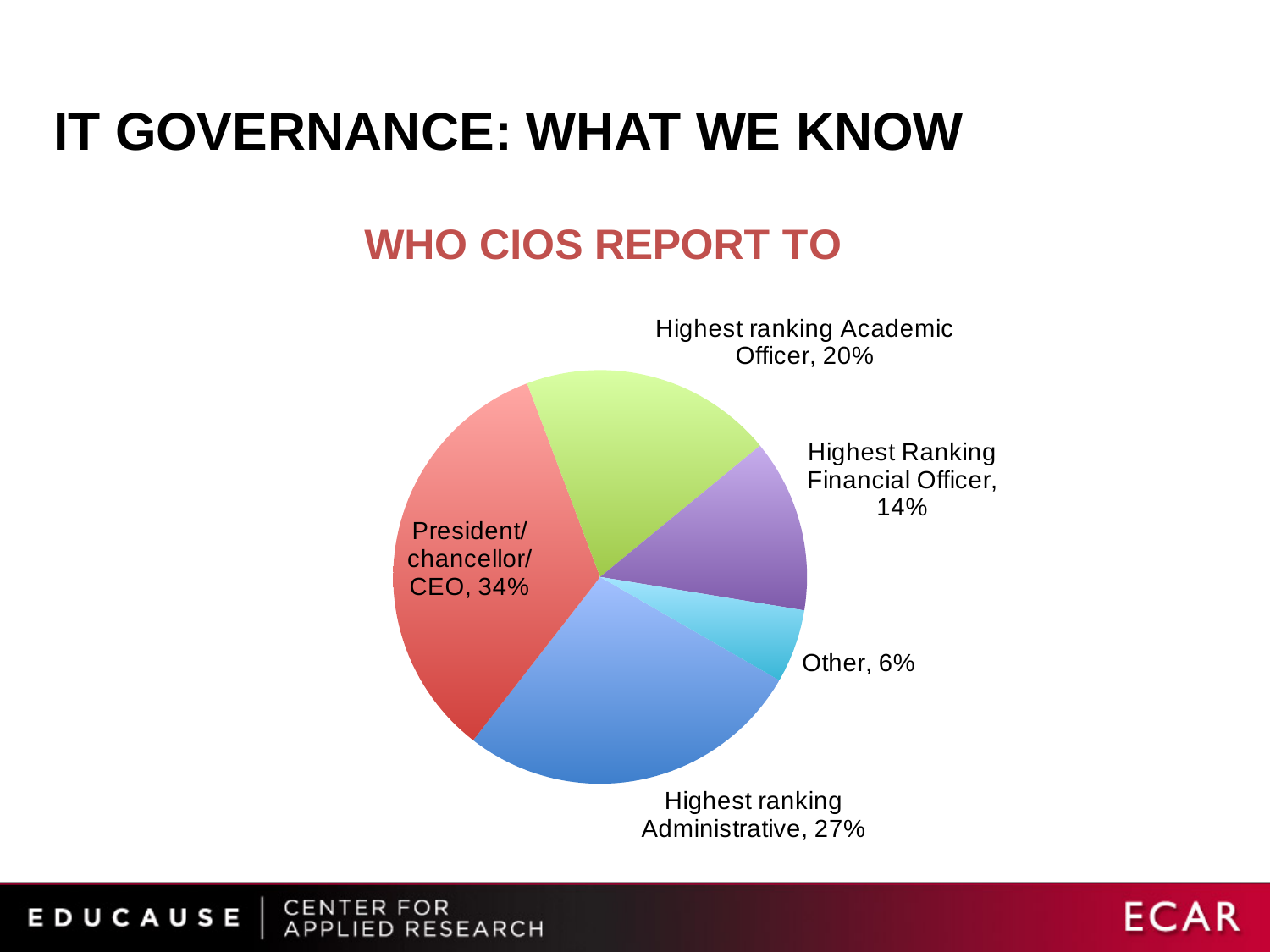
What is the value for the Other slice? 6% What percentage of CIOs report to the Highest Ranking Financial Officer? 14% What percentage of CIOs report to the Highest ranking Academic Officer? 20% Which category has the largest share of the pie? President/chancellor/CEO What kind of chart is shown on the slide? pie chart What percentage of CIOs report to the President/chancellor/CEO? 34% Which category has the smallest share of the pie? Other Which is larger, the Highest ranking Academic Officer share or the Highest Ranking Financial Officer share? Highest ranking Academic Officer What is the difference between the President/chancellor/CEO share and the Highest ranking Administrative share? 7% How many slices does the pie chart have? 5 What percentage of CIOs report to the Highest ranking Administrative officer? 27% What is the title of the chart? WHO CIOS REPORT TO